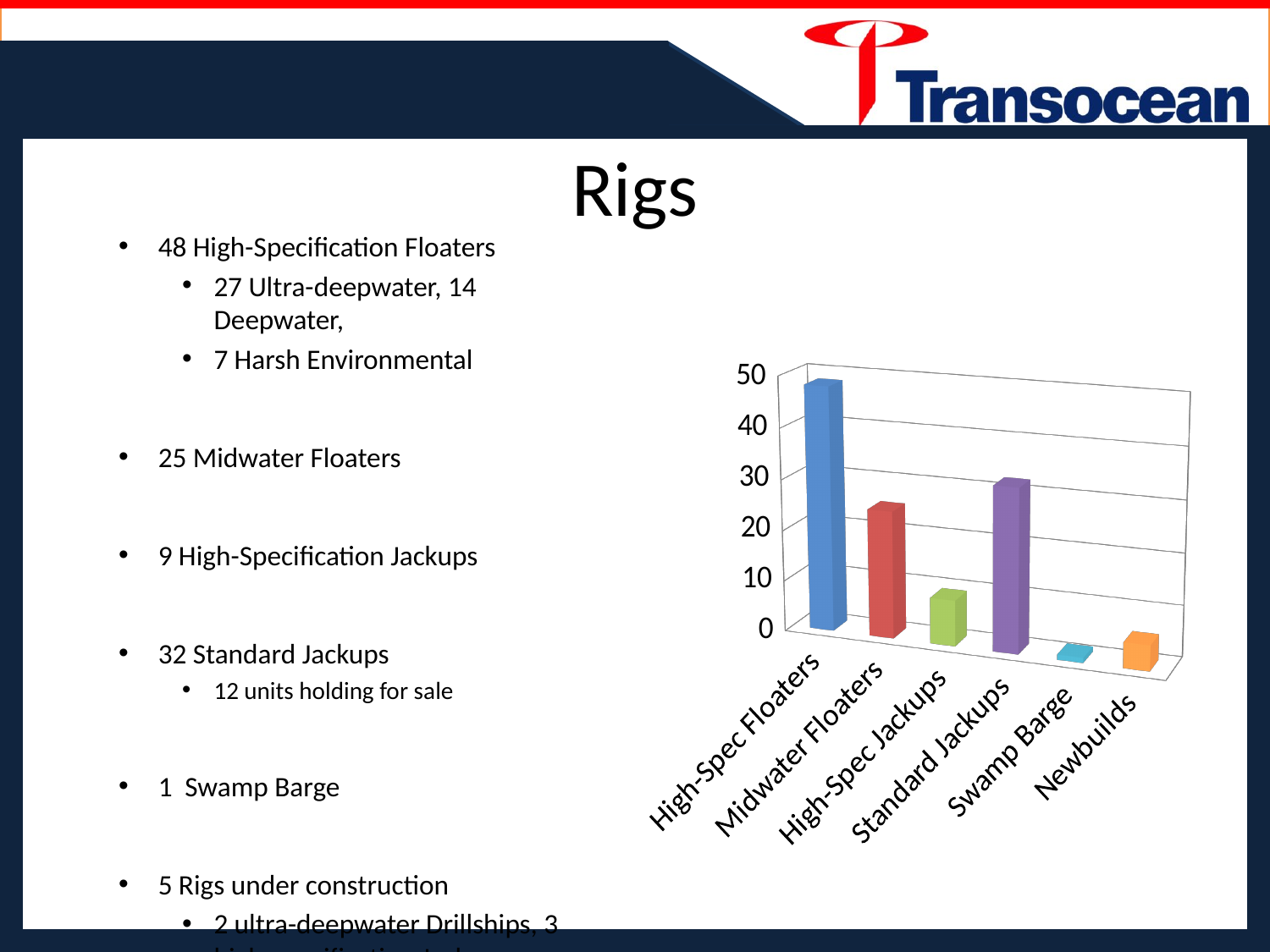
Which is larger, the bar for Standard Jackups or the bar for Midwater Floaters? Standard Jackups How many categories are shown on the chart's x axis? 6 Which is larger, the bar for High-Spec Jackups or the bar for Newbuilds? High-Spec Jackups Is the value for Swamp Barge greater or less than 10? less Is the value for Newbuilds greater or less than 10? less What kind of chart is shown on the slide? bar chart Is the value for Midwater Floaters greater or less than 20? greater Which category has the tallest bar in the chart? High-Spec Floaters What colour is the bar for High-Spec Floaters? blue Which category has the shortest bar in the chart? Swamp Barge